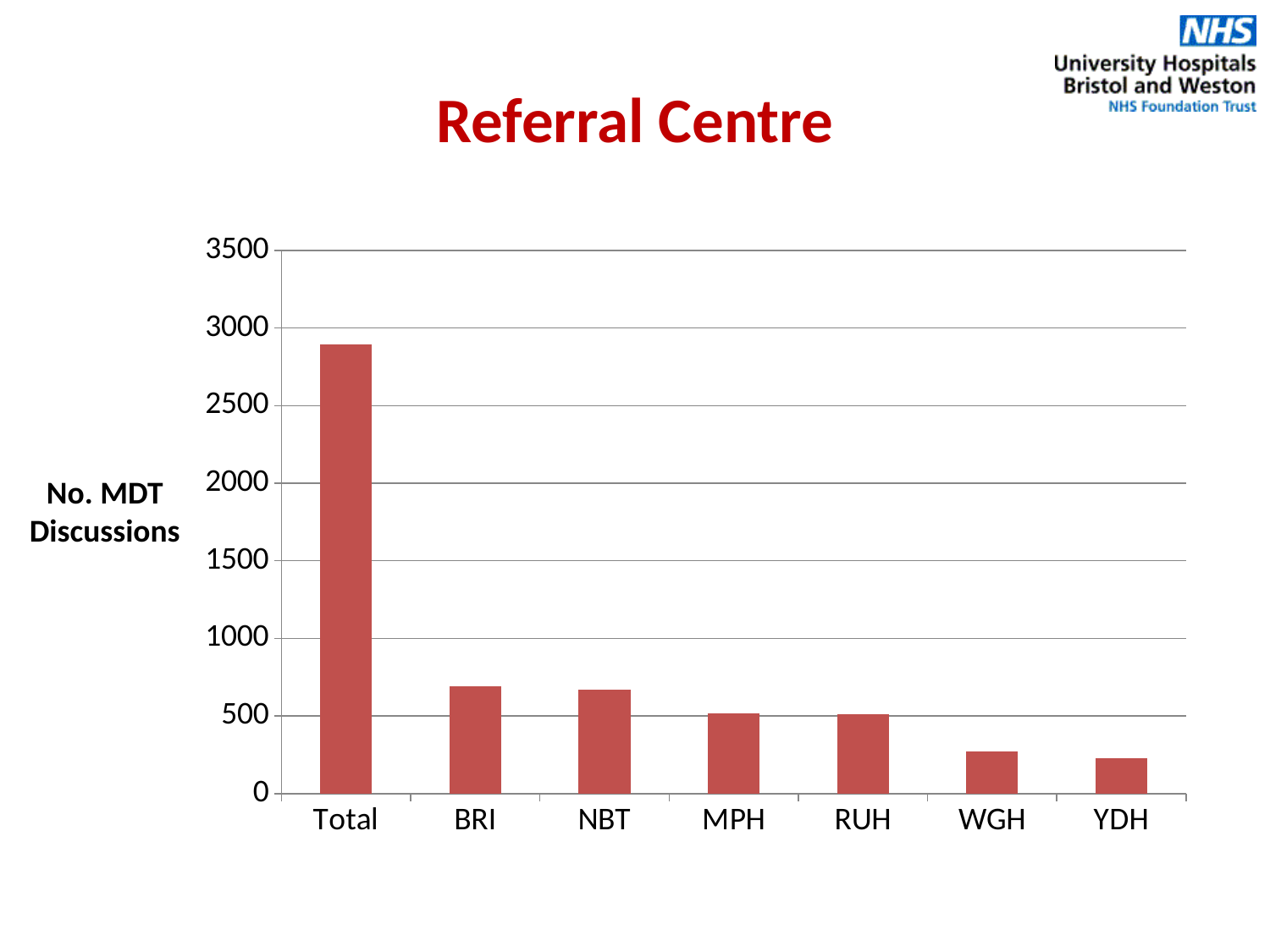
What is the label on the vertical axis of the chart? No. MDT Discussions Is the value for BRI greater or less than 500? greater Is the value for NBT greater or less than 1000? less Which is larger, the value for BRI or the value for WGH? BRI Is the value for WGH greater or less than 500? less Do the values rise or fall moving from left to right along the x axis? fall What kind of chart is shown on the slide? bar chart Which category has the highest value in the chart? Total How many categories are shown on the x axis of the chart? 7